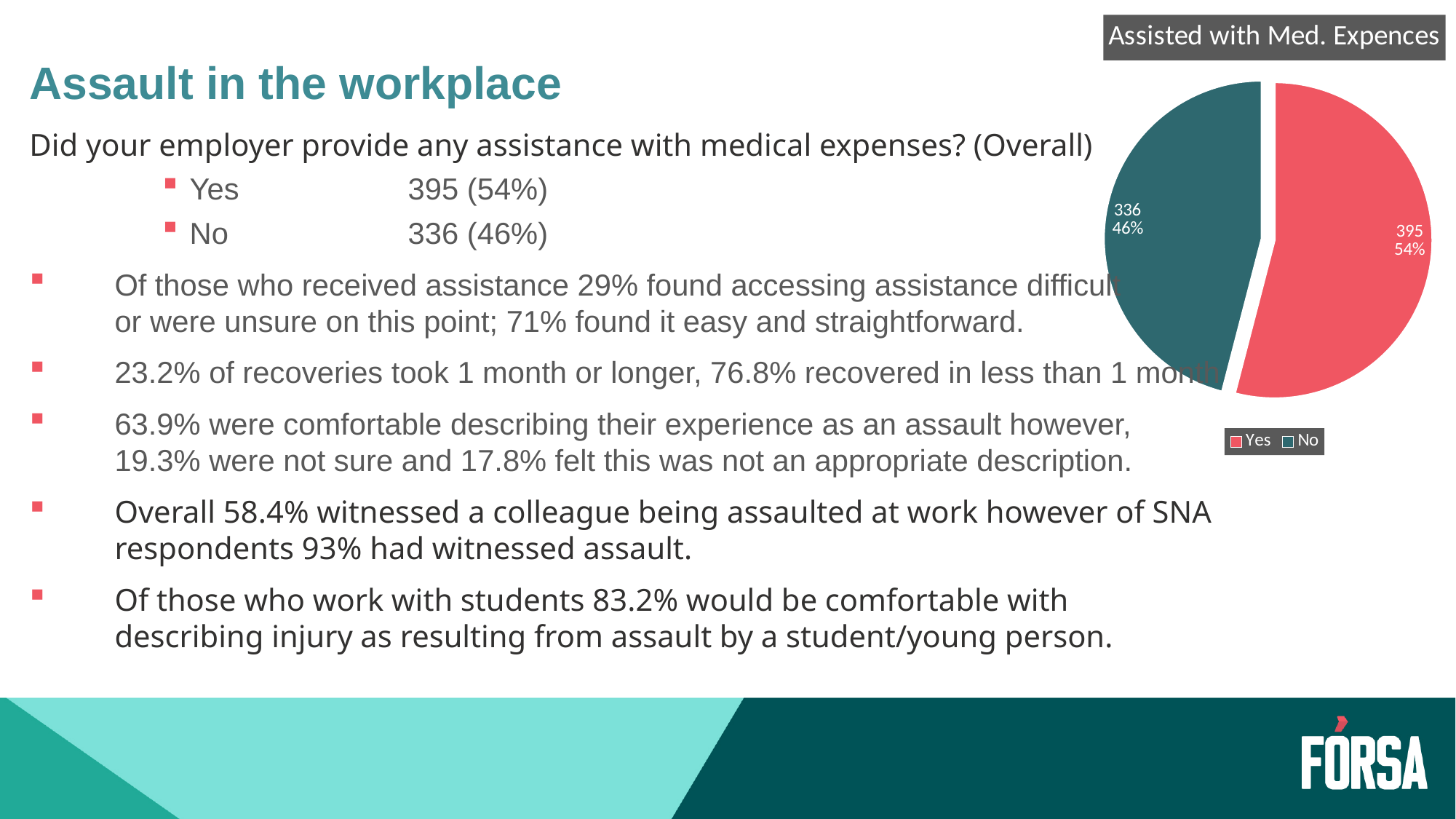
What kind of chart is shown on the slide? pie chart Which slice is the largest in the pie chart? Yes What percentage share does the Yes slice represent? 54% What is the difference between the Yes count and the No count? 59 What is the title of the chart? Assisted with Med. Expences How many entries does the chart legend list? 2 How many slices does the pie chart have? 2 What count is shown for the No slice? 336 What percentage share does the No slice represent? 46% What count is shown for the Yes slice? 395 Which slice is the smallest in the pie chart? No Which colour represents the No slice in the pie chart? dark teal